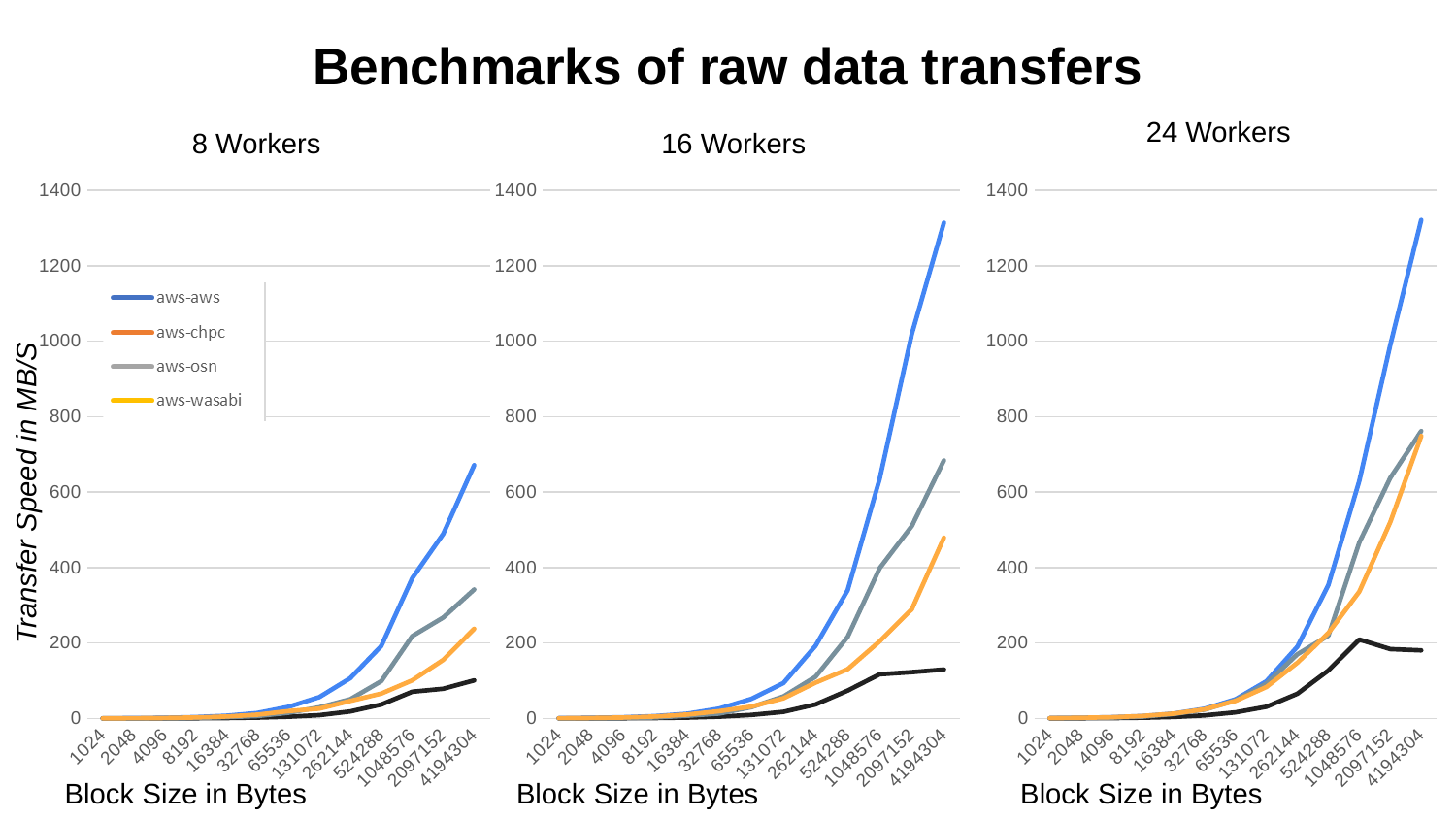
How many block sizes are shown along the x axis of the 16 Workers chart? 13 How many series does the legend on the 8 Workers chart list? 4 In the 16 Workers chart, does the aws-aws line rise or fall as block size increases? rise What is the y-axis label on the charts? Transfer Speed in MB/S In the 24 Workers chart, is the aws-aws value at block size 4194304 greater or less than 1200? greater In the 8 Workers chart, is the aws-aws value at block size 4194304 greater or less than 600? greater What kind of chart is the 8 Workers chart? line chart In the 8 Workers chart, is the aws-osn value at block size 4194304 greater or less than 400? less In the 16 Workers chart, which series has the highest transfer speed at block size 4194304? aws-aws What is the title of the slide's set of charts? Benchmarks of raw data transfers In the 24 Workers chart, which is larger at block size 4194304, aws-aws or aws-osn? aws-aws